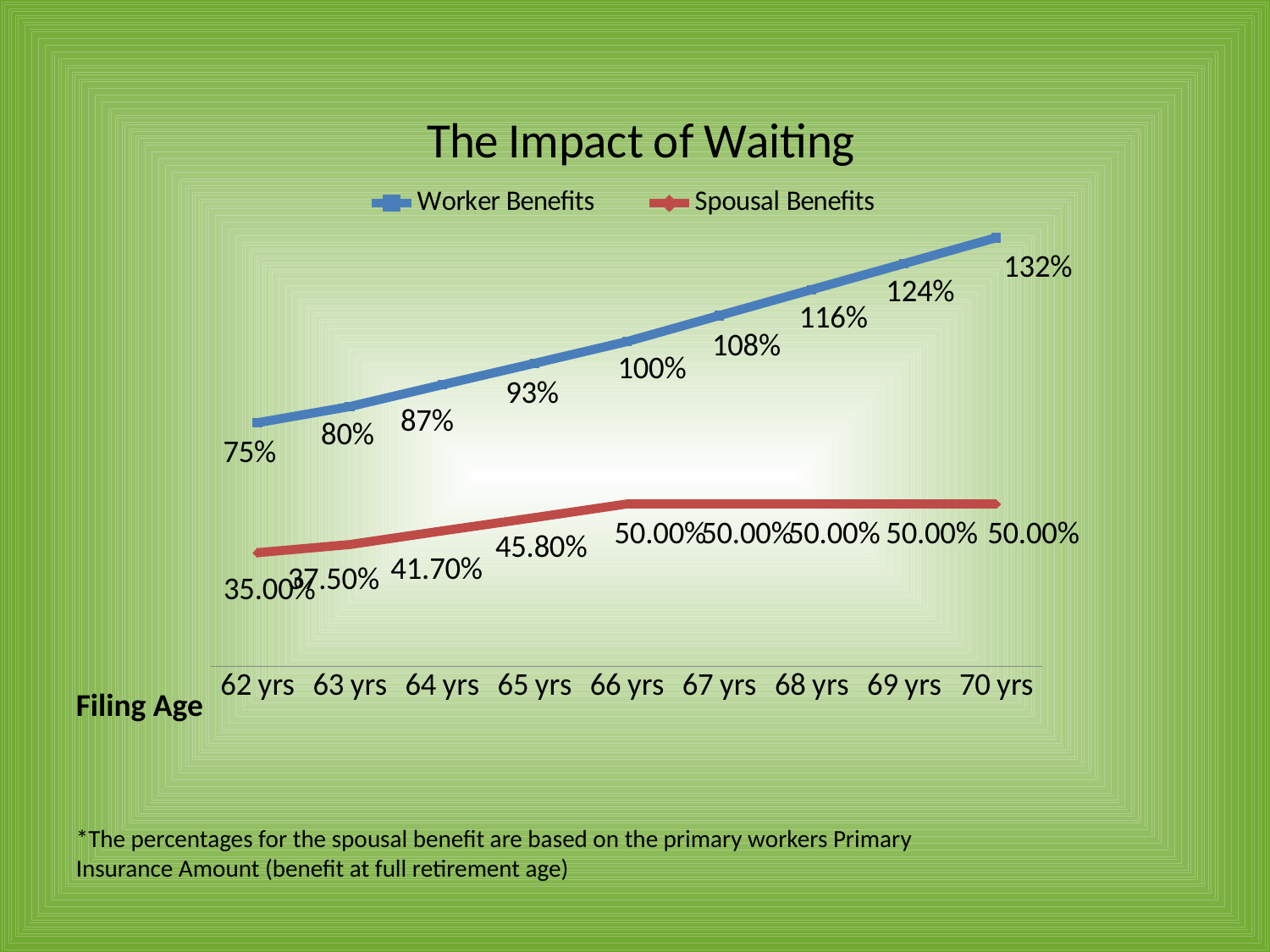
What kind of chart is shown on the slide? Line chart What is the title of the chart? The Impact of Waiting How many filing ages are shown on the x axis? 9 At which filing age is the Worker Benefits value lowest? 62 yrs Do the Worker Benefits values rise or fall as filing age increases from 62 yrs to 70 yrs? Rise Which is larger at 65 yrs: the Worker Benefits value or the Spousal Benefits value? Worker Benefits How many series does the legend list? 2 What is the Worker Benefits value at a filing age of 66 yrs? 100% What is the difference between the Worker Benefits value at 70 yrs and at 62 yrs? 57% What is the Worker Benefits value at a filing age of 70 yrs? 132% At which filing age is the Worker Benefits value highest? 70 yrs What is the Spousal Benefits value at a filing age of 64 yrs? 41.70%